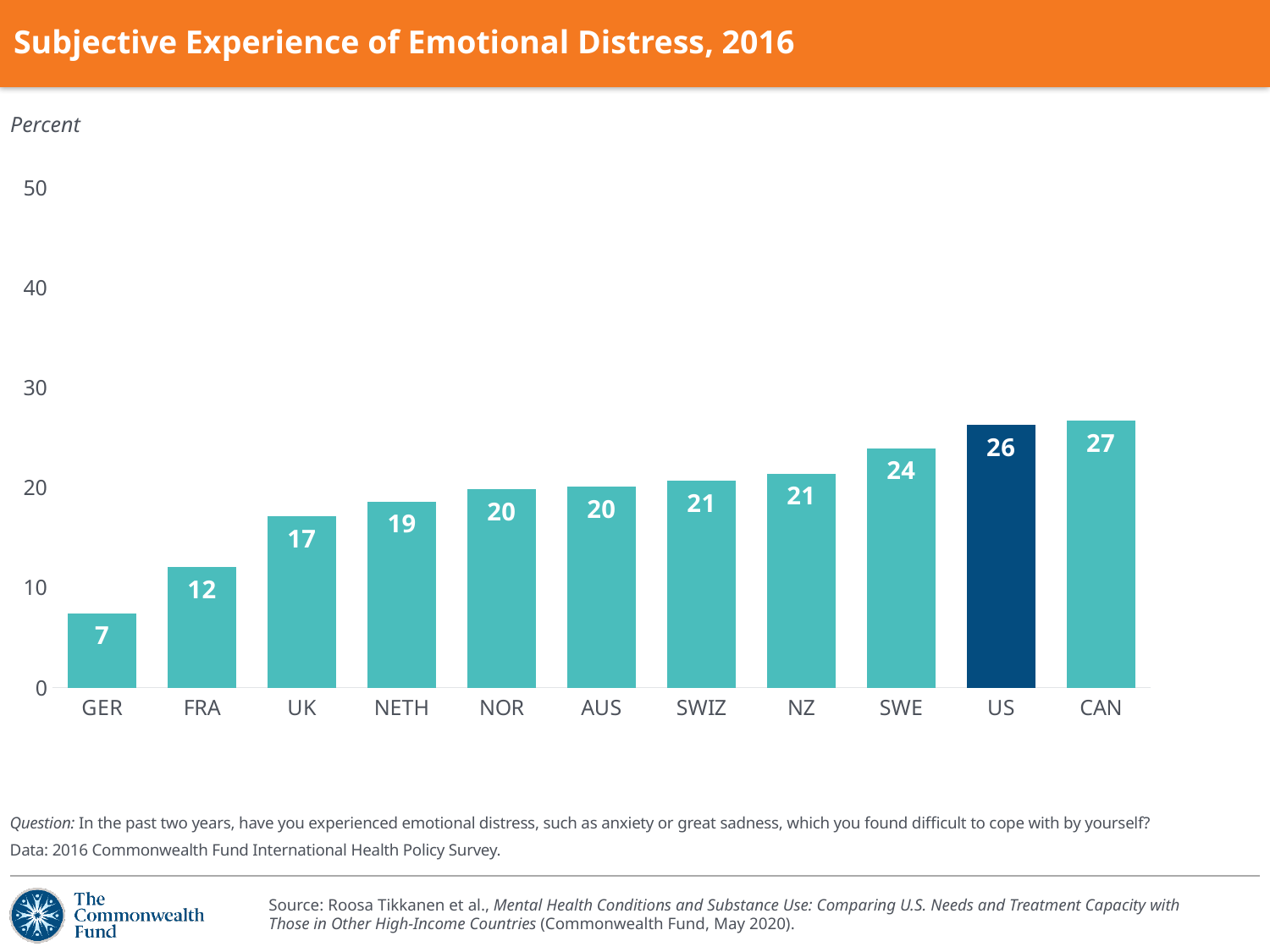
What is the value for SWE? 24 What is the title of the chart? Subjective Experience of Emotional Distress, 2016 Do the values rise or fall from GER to CAN along the x axis? rise Which country has the lowest value? GER Which country has the highest value? CAN What is the difference between the values for CAN and GER? 20 How many countries are shown on the chart? 11 Which is larger, the value for FRA or the value for NETH? NETH What is the difference between the values for US and UK? 9 What kind of chart is shown on the slide? bar chart What is the value for GER? 7 What is the value for the US? 26